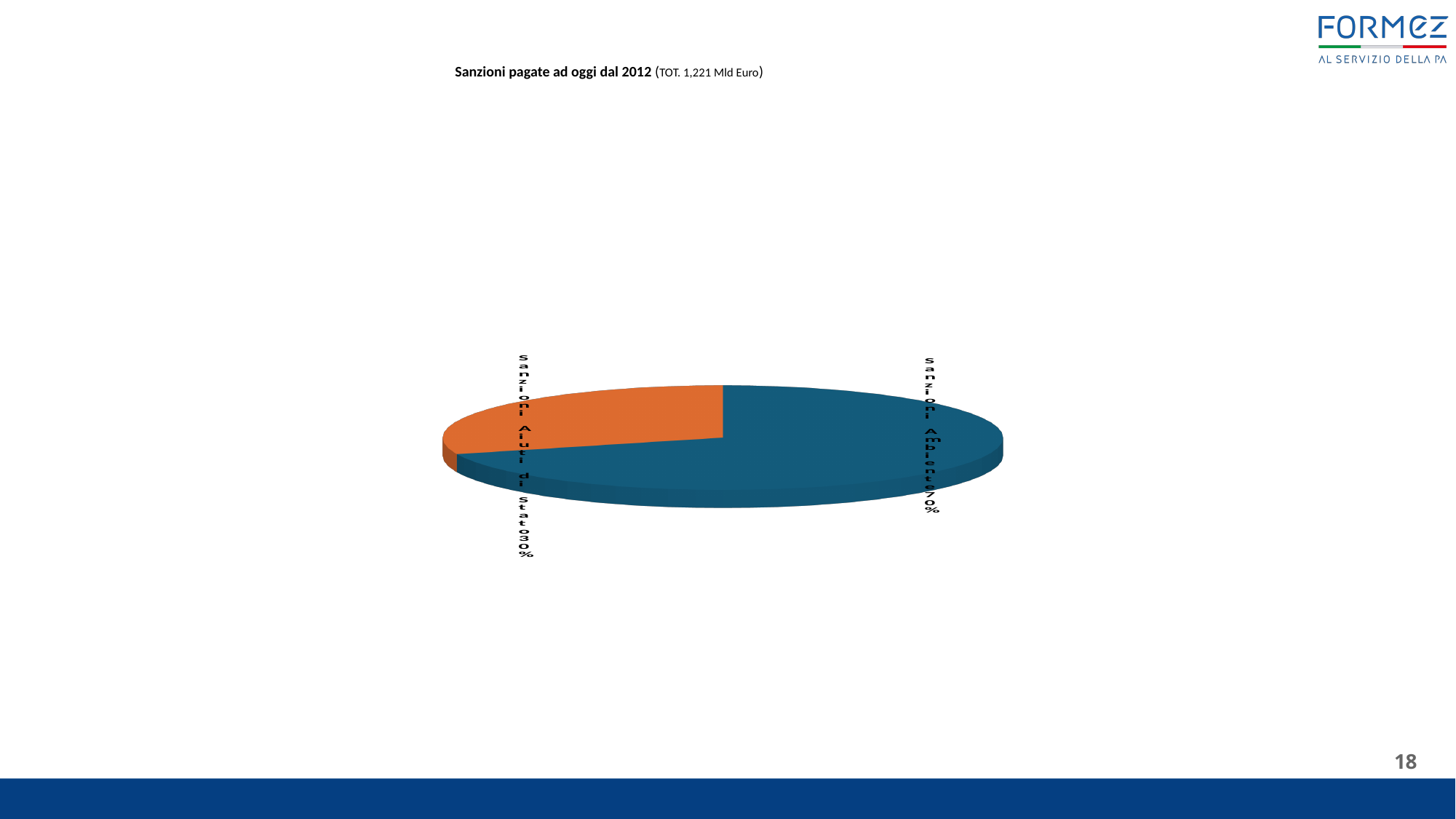
What is the title of the chart? Sanzioni pagate ad oggi dal 2012 (TOT. 1,221 Mld Euro) Which is larger, the share for Sanzioni Ambiente or the share for Sanzioni Aiuti di Stato? Sanzioni Ambiente How many slices does the pie chart have? 2 What total amount is stated in the chart title? 1,221 Mld Euro What kind of chart is shown on the slide? pie chart What share of the pie does Sanzioni Aiuti di Stato represent? 30% What share of the pie does Sanzioni Ambiente represent? 70% Which slice of the pie is the largest? Sanzioni Ambiente Which slice of the pie is the smallest? Sanzioni Aiuti di Stato What is the difference in percentage points between the Sanzioni Ambiente share and the Sanzioni Aiuti di Stato share? 40 percentage points